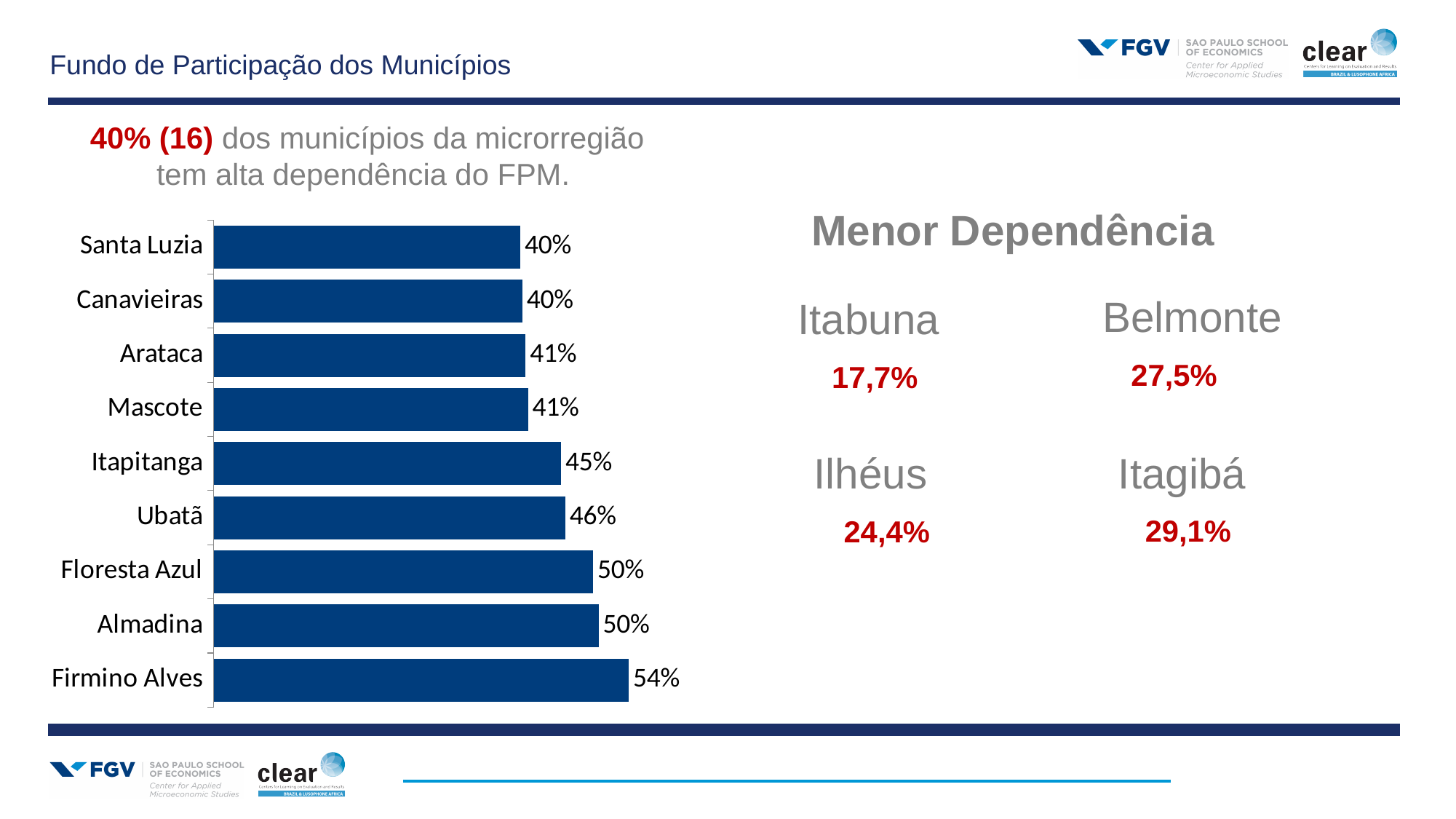
What is the value for Ubatã? 46% What is the value for Itapitanga? 45% Which is larger, the value for Ubatã or the value for Arataca? Ubatã What is the difference between the values for Floresta Azul and Itapitanga? 5% Which municipality has the highest value in the chart? Firmino Alves Which is larger, the value for Almadina or the value for Canavieiras? Almadina What kind of chart is shown on the slide? Bar chart Do the values increase or decrease going from the top bar (Santa Luzia) to the bottom bar (Firmino Alves)? Increase What is the value for Firmino Alves? 54% How many municipalities are shown in the bar chart? 9 What is the difference between the values for Firmino Alves and Santa Luzia? 14% What is the value for Mascote? 41%